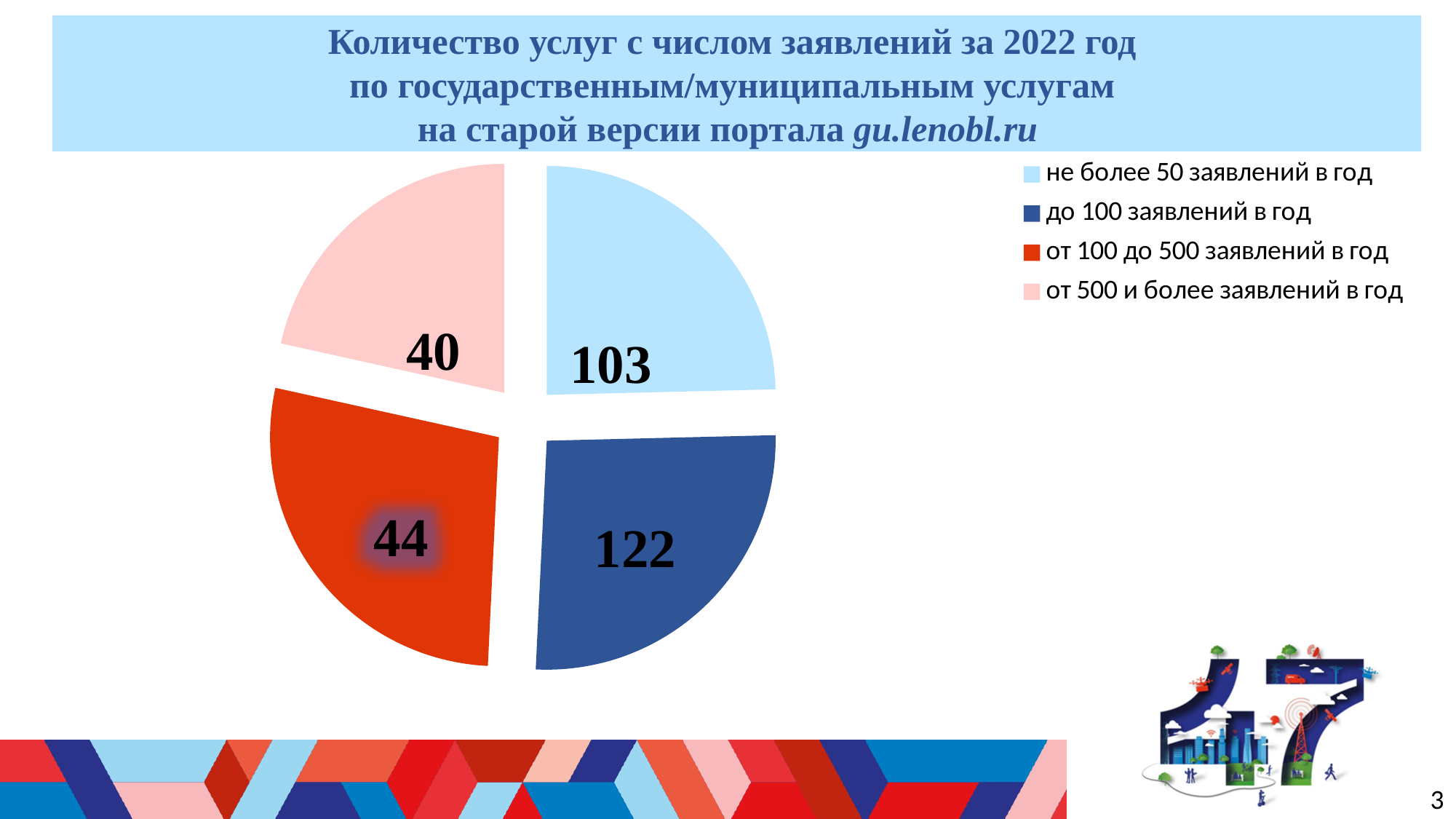
What kind of chart is shown on the slide? pie chart What is the value for "от 100 до 500 заявлений в год"? 44 What is the difference between the values for "до 100 заявлений в год" and "не более 50 заявлений в год"? 19 What colour is the slice for "от 100 до 500 заявлений в год"? red What is the value for "от 500 и более заявлений в год"? 40 How many entries does the legend list? 4 What is the value for "не более 50 заявлений в год"? 103 How many slices does the pie chart have? 4 What is the value for "до 100 заявлений в год"? 122 Which is larger: the value for "от 100 до 500 заявлений в год" or for "от 500 и более заявлений в год"? от 100 до 500 заявлений в год